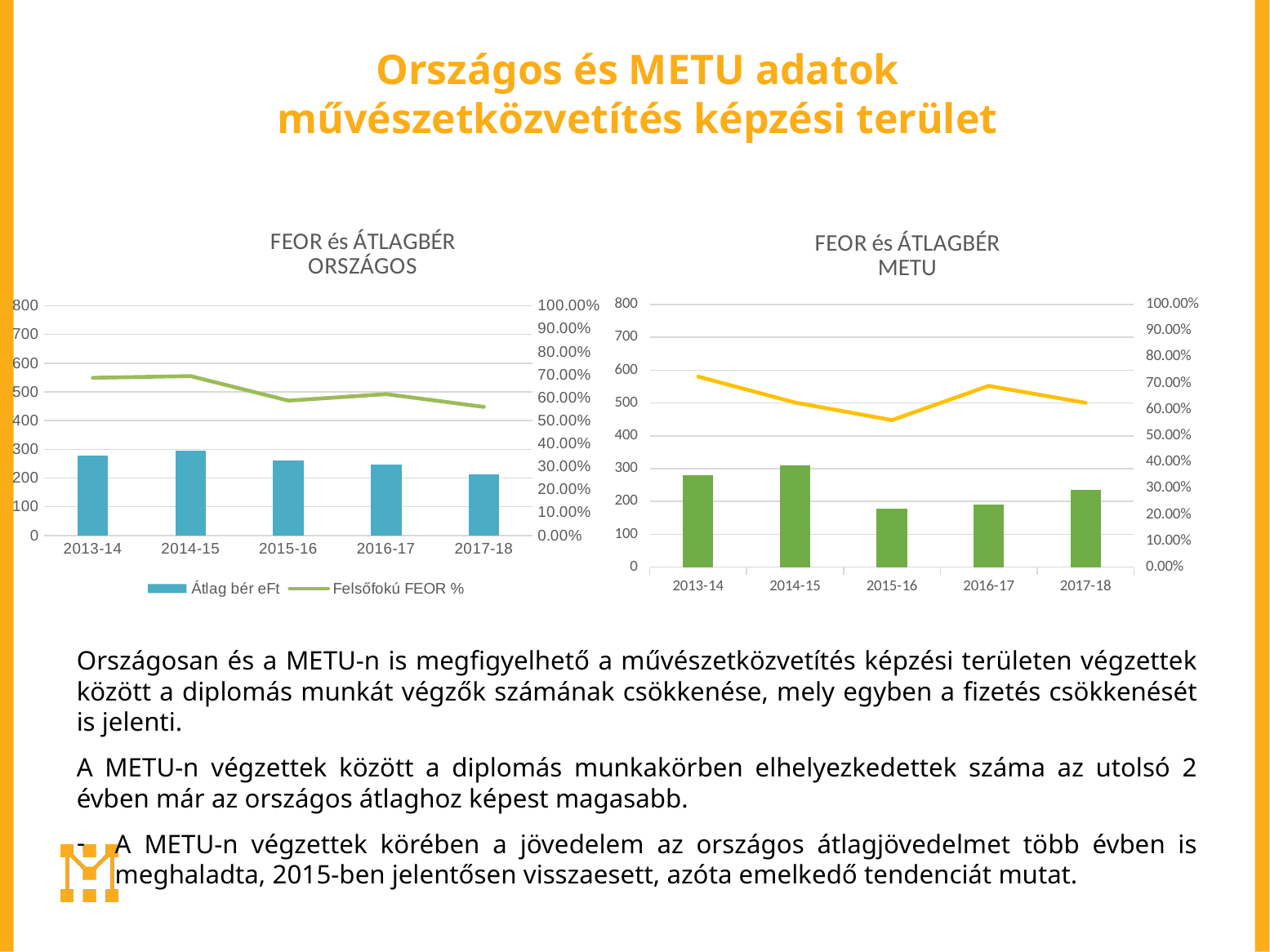
In the right chart (FEOR és ÁTLAGBÉR METU), which year has the highest bar? 2014-15 In the left chart (FEOR és ÁTLAGBÉR ORSZÁGOS), which year has the highest Átlag bér eFt bar? 2014-15 In the left chart (FEOR és ÁTLAGBÉR ORSZÁGOS), is the Átlag bér eFt bar for 2014-15 greater or less than 200? greater In the left chart (FEOR és ÁTLAGBÉR ORSZÁGOS), what kind of chart is used for the Átlag bér eFt series? bar chart In the right chart (FEOR és ÁTLAGBÉR METU), which year has the lowest bar? 2015-16 In the right chart (FEOR és ÁTLAGBÉR METU), is the bar for 2015-16 greater or less than 200? less In the right chart (FEOR és ÁTLAGBÉR METU), how many academic years are shown on the x axis? 5 In the left chart (FEOR és ÁTLAGBÉR ORSZÁGOS), which year has the lowest Átlag bér eFt bar? 2017-18 What is the title of the right chart? FEOR és ÁTLAGBÉR METU In the right chart (FEOR és ÁTLAGBÉR METU), is the bar for 2017-18 larger or smaller than the bar for 2015-16? larger In the left chart (FEOR és ÁTLAGBÉR ORSZÁGOS), does the Felsőfokú FEOR % line overall rise or fall from 2013-14 to 2017-18? fall In the left chart (FEOR és ÁTLAGBÉR ORSZÁGOS), how many series does the legend list? 2